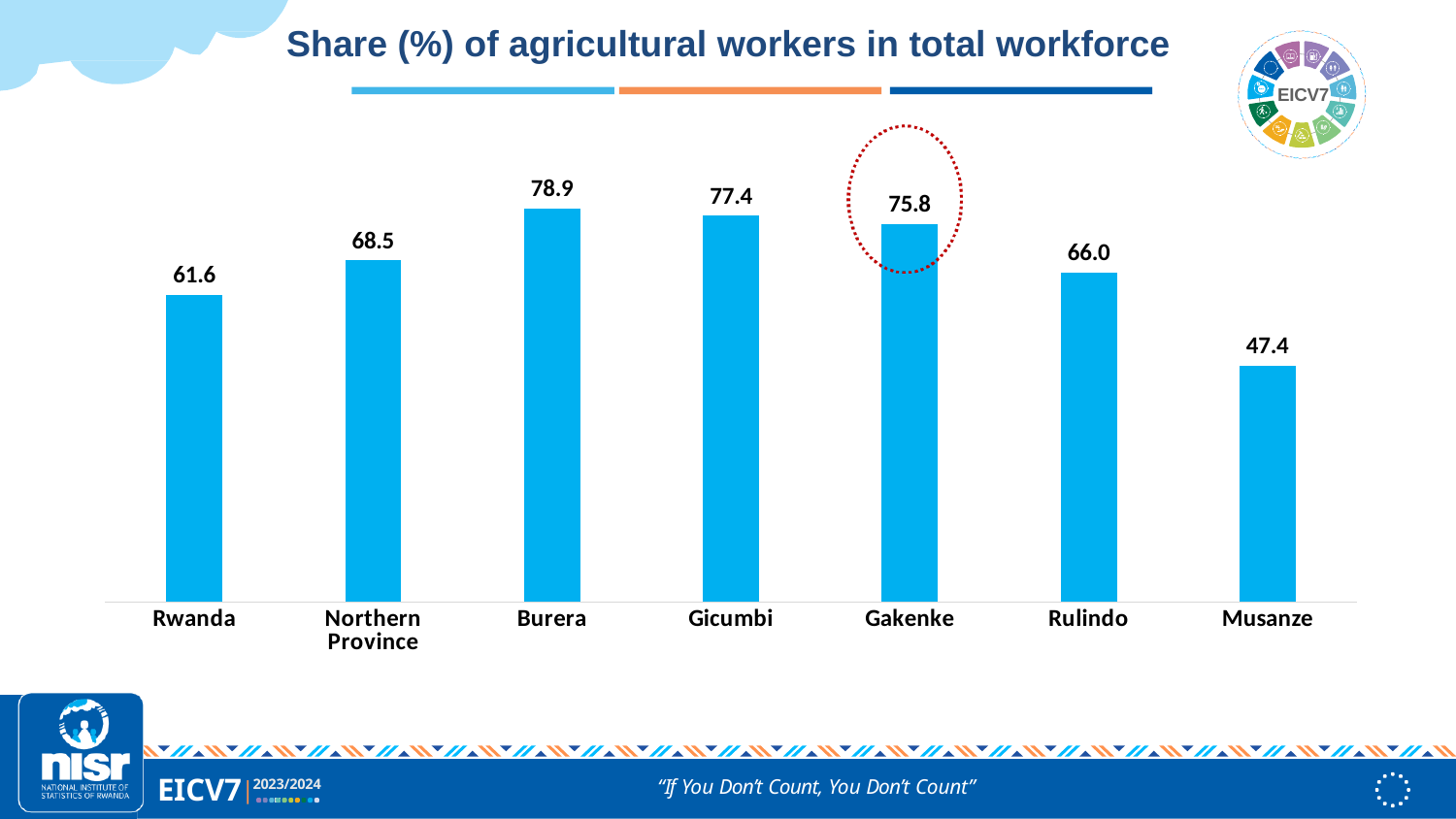
Which category has the highest share of agricultural workers? Burera How many categories are shown on the x axis? 7 What is the difference between the values for Gicumbi and Gakenke? 1.6 What is the difference between the values for Burera and Musanze? 31.5 Which bar is highlighted with a dotted red circle? Gakenke What is the title of the chart? Share (%) of agricultural workers in total workforce What is the value shown for Rwanda? 61.6 What is the share of agricultural workers in the total workforce for Gakenke? 75.8 What is the value shown for Northern Province? 68.5 Which category has the lowest share of agricultural workers? Musanze Which has a larger share of agricultural workers, Rulindo or Northern Province? Northern Province What kind of chart is shown on the slide? Bar chart